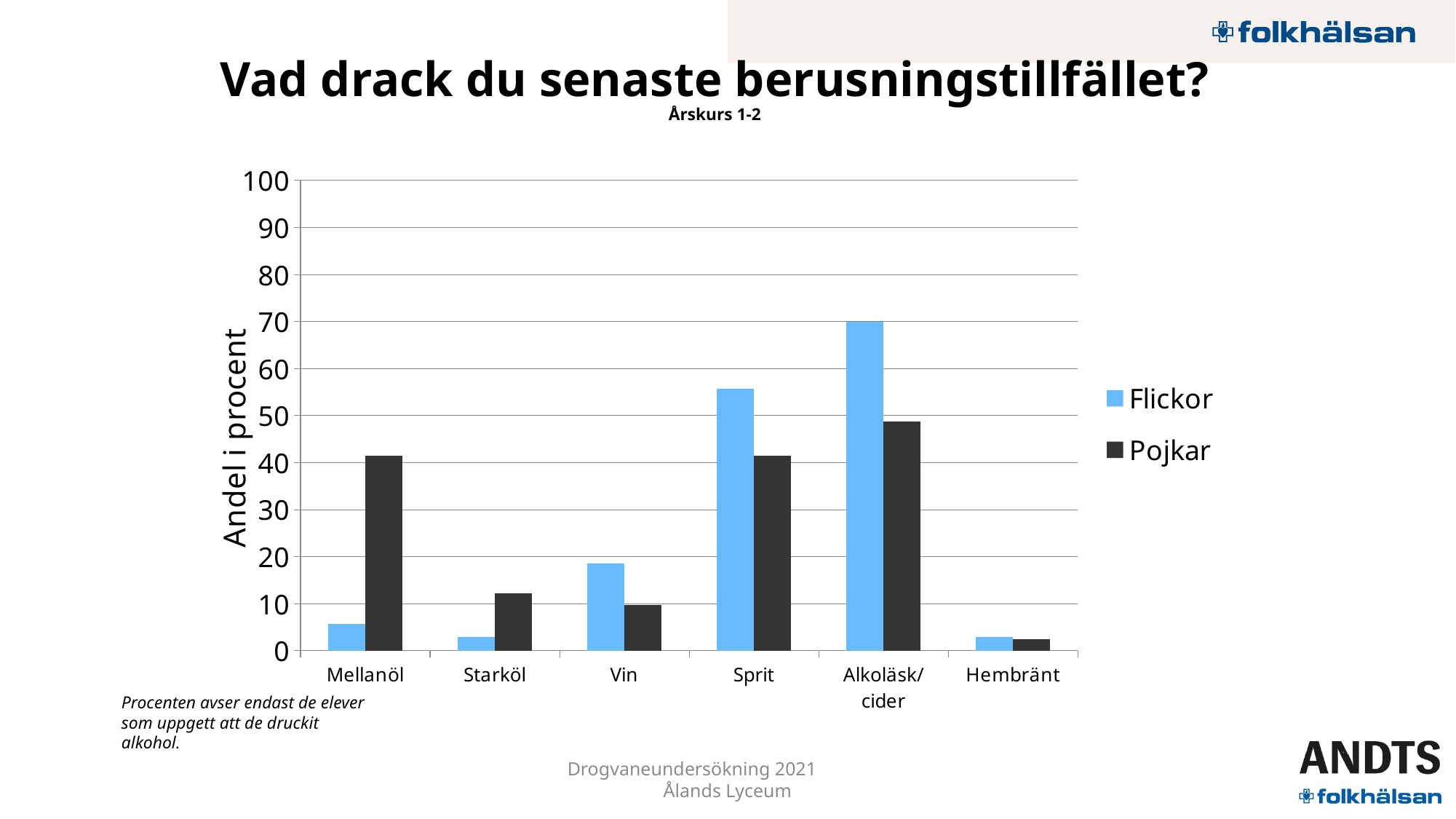
Which category has the highest value for Pojkar? Alkoläsk/cider Which category has the lowest value for Pojkar? Hembränt Is the value for Flickor in the Sprit category greater or less than 50? greater What is the title of the y axis? Andel i procent For Mellanöl, which series has the larger value, Flickor or Pojkar? Pojkar For Sprit, which series has the larger value, Flickor or Pojkar? Flickor Which category has the highest value for Flickor? Alkoläsk/cider Is the value for Pojkar in the Mellanöl category greater or less than 50? less Is the value for Flickor in the Mellanöl category greater or less than 10? less How many series does the legend list? 2 How many drink categories are shown on the x axis? 6 What kind of chart is shown on the slide? bar chart